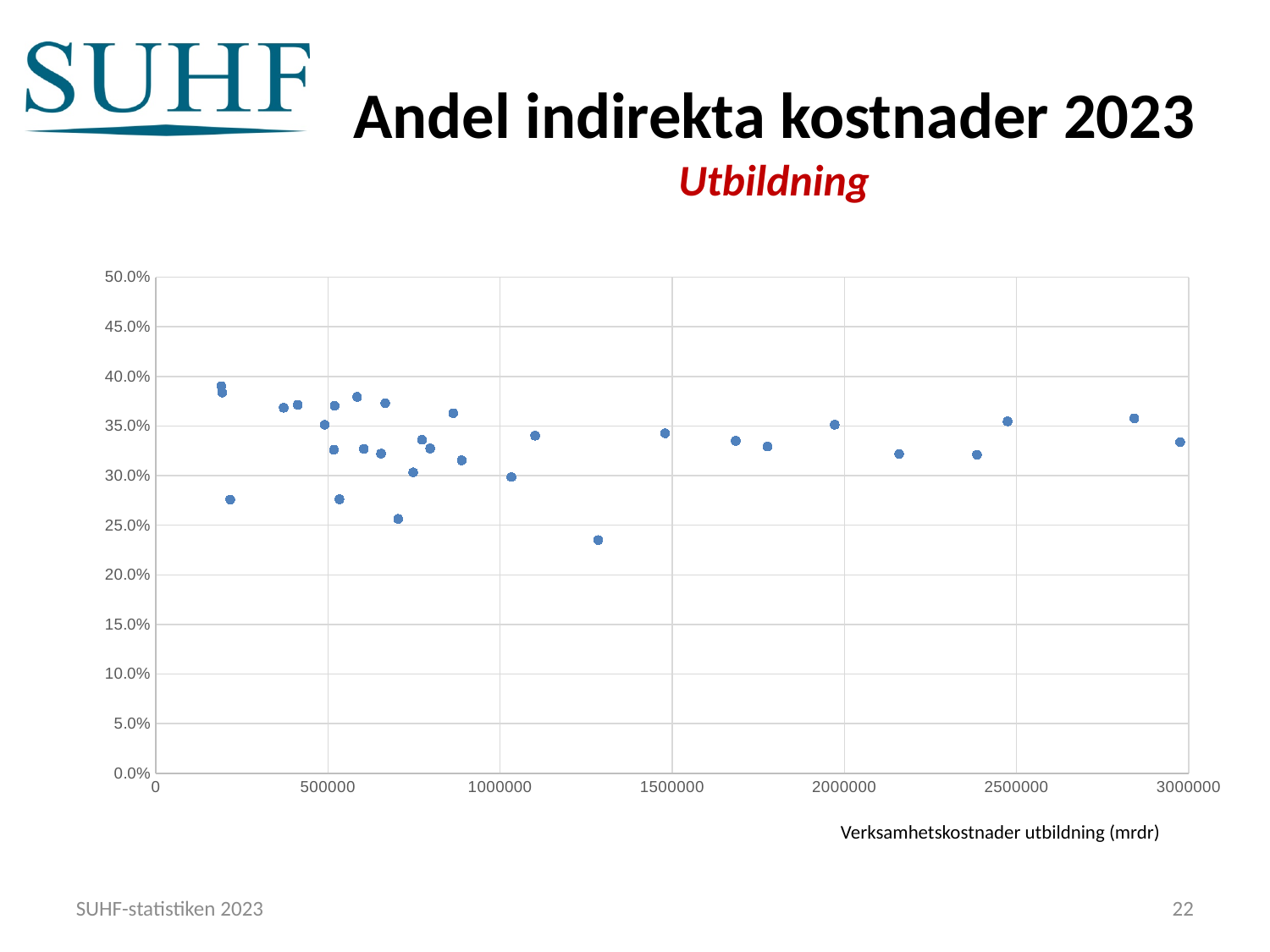
What is the title shown above the chart? Andel indirekta kostnader 2023 Is the lowest plotted value in the chart greater or less than 20.0%? greater What is the title of the x axis of the chart? Verksamhetskostnader utbildning (mrdr) Is the value of the highest point in the chart greater or less than 35.0%? greater Is the value of the lowest point in the chart greater or less than 25.0%? less What kind of chart is shown on the slide? scatter chart